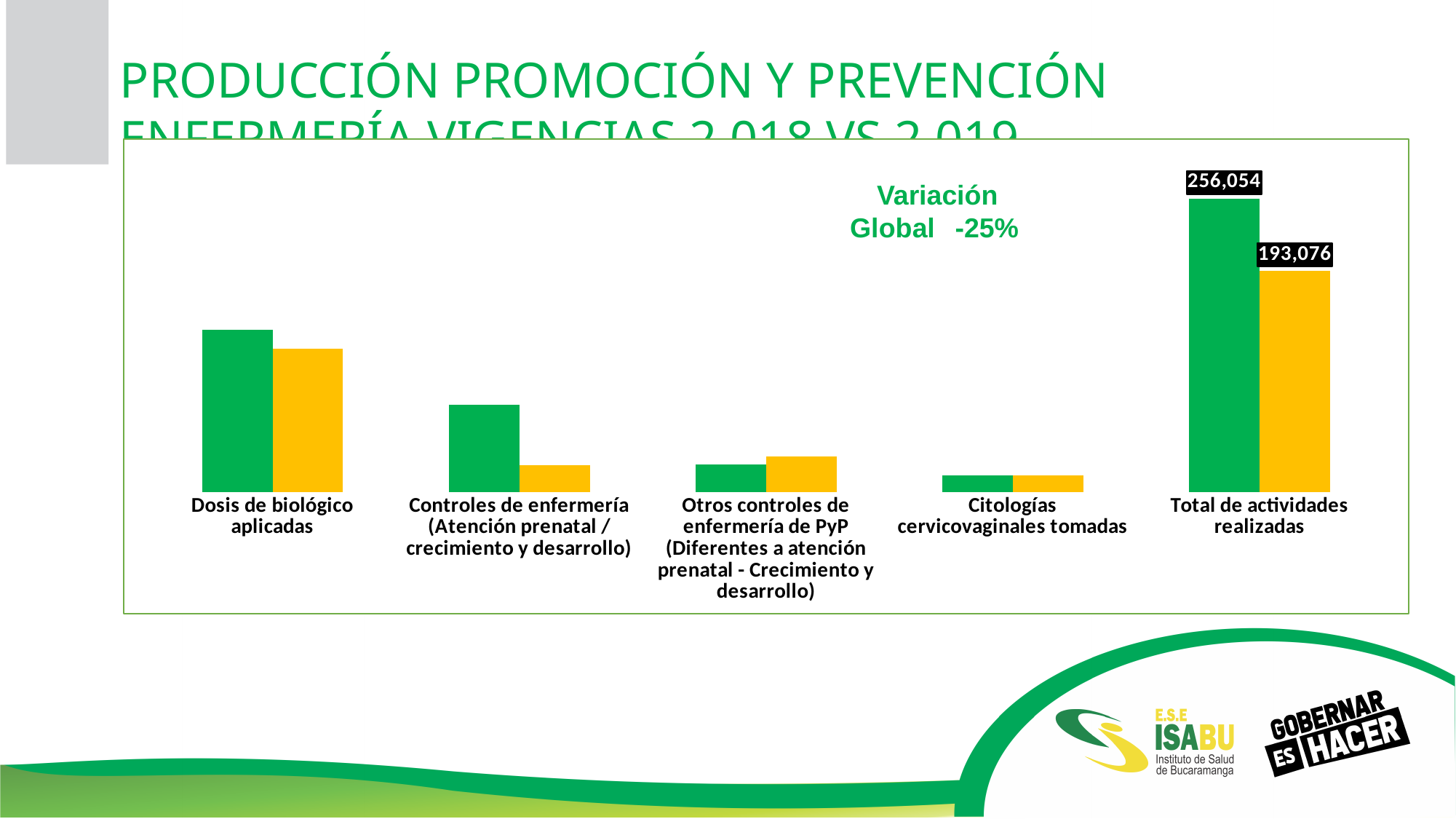
For Otros controles de enfermería de PyP, which bar is taller, the green or the yellow? yellow What is the value of the yellow bar for Total de actividades realizadas? 193,076 For Dosis de biológico aplicadas, which bar is taller, the green or the yellow? green What kind of chart is shown on the slide? bar chart How many categories are shown on the x axis? 5 For Controles de enfermería (Atención prenatal / crecimiento y desarrollo), which bar is taller, the green or the yellow? green What Variación Global percentage is printed on the chart? -25% Which category has the shortest bars? Citologías cervicovaginales tomadas What is the difference between the green and yellow bars for Total de actividades realizadas? 62,978 Which category has the tallest bars? Total de actividades realizadas What is the value of the green bar for Total de actividades realizadas? 256,054